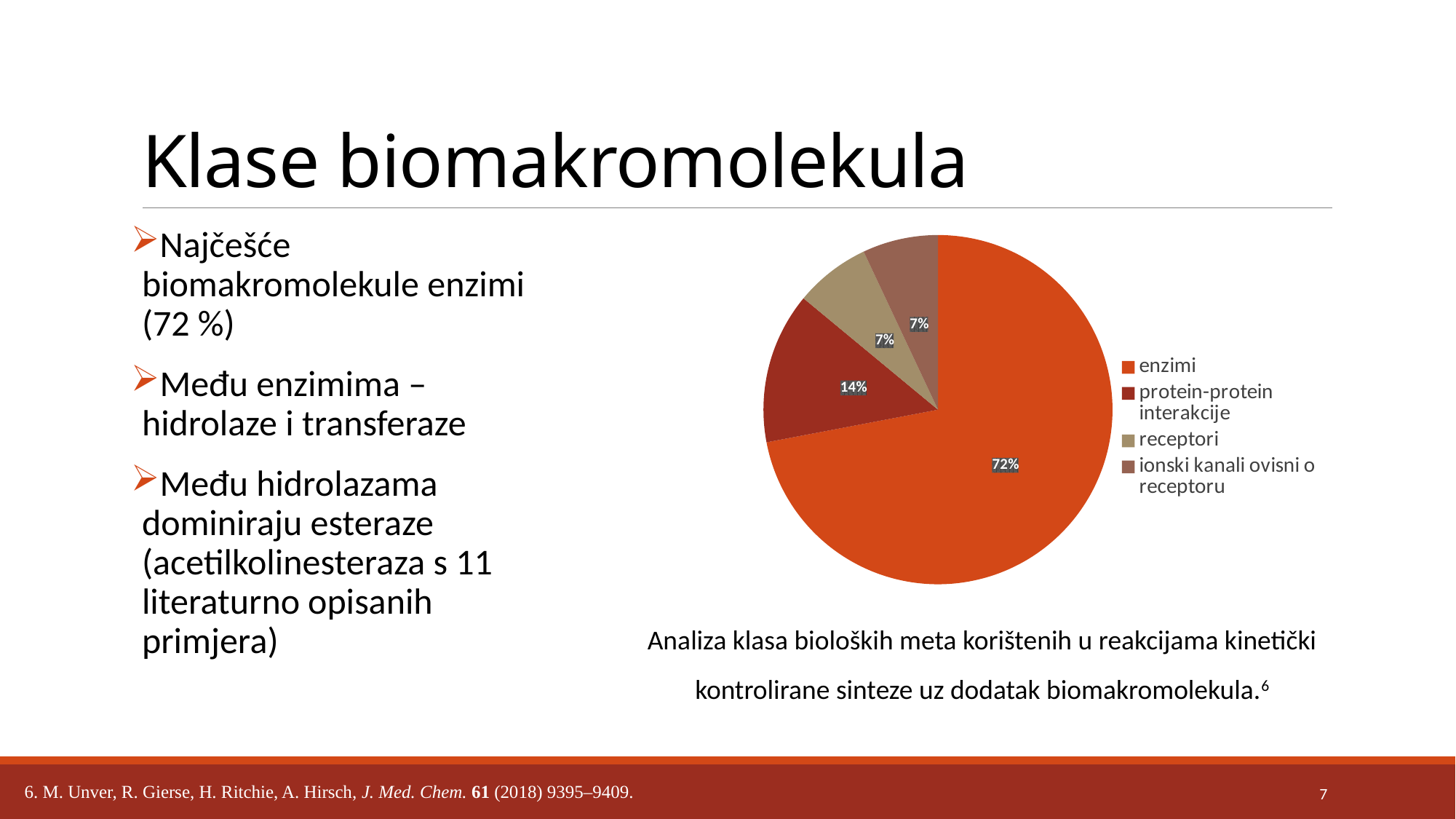
What share of the pie does the "protein-protein interakcije" slice represent? 14% What is the combined share of the "receptori" and "ionski kanali ovisni o receptoru" slices? 14% How many categories does the legend of the pie chart list? 4 What is the difference in percentage points between the "enzimi" slice and the "protein-protein interakcije" slice? 58 What share of the pie does the "enzimi" slice represent? 72% Which is larger, the "protein-protein interakcije" slice or the "receptori" slice? protein-protein interakcije How many slices does the pie chart have? 4 What share of the pie does the "receptori" slice represent? 7% Which legend entry is shown in the lightest (tan) colour? receptori Which category has the largest slice of the pie? enzimi What kind of chart is shown on the slide? pie chart